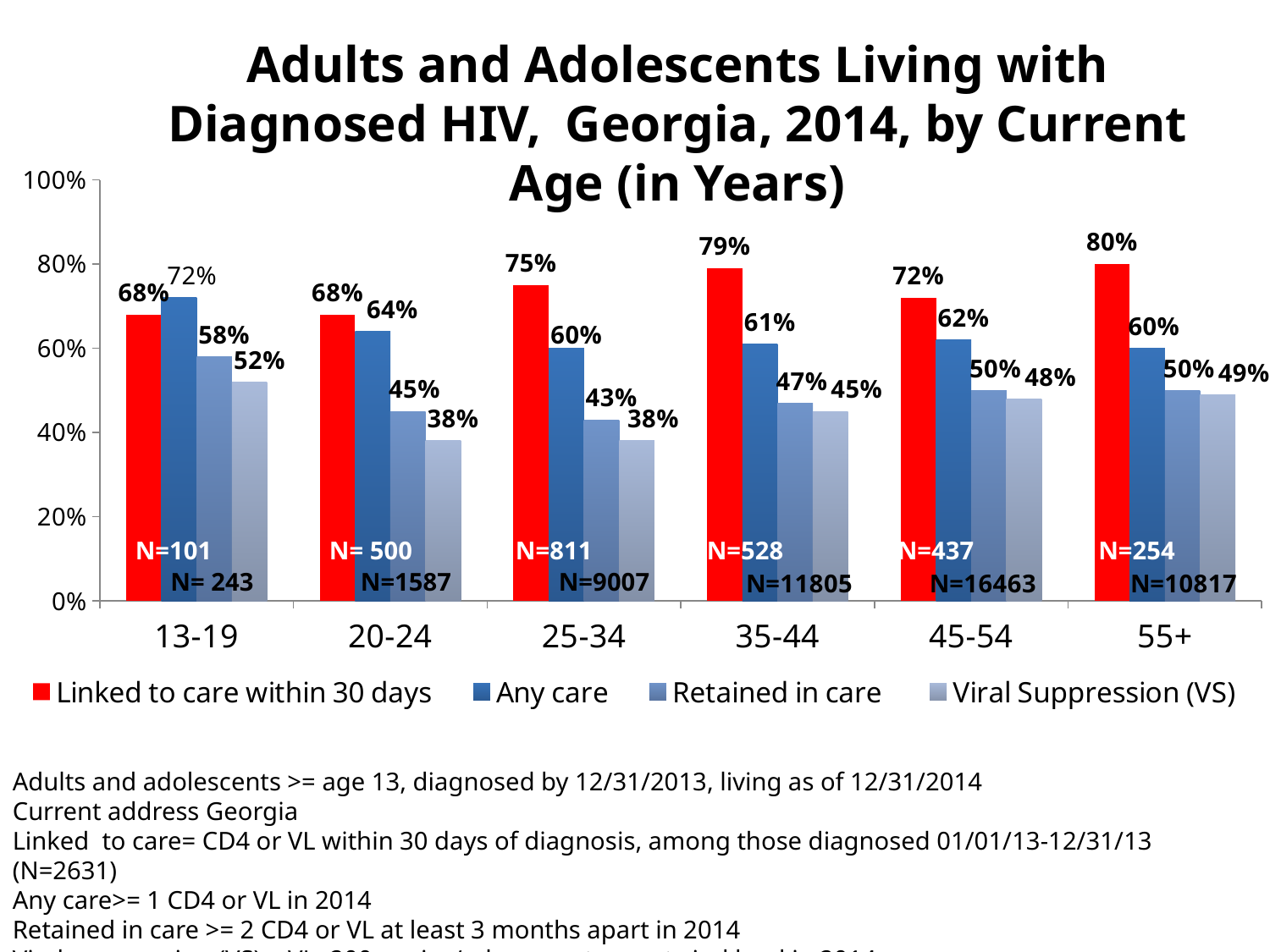
How many series does the legend list? 4 What is the Viral Suppression (VS) value for the 20-24 age group? 38% What kind of chart is shown on the slide? Bar chart Which age group has the highest value for Linked to care within 30 days? 55+ How many age groups are shown on the x axis? 6 What percentage of the 35-44 age group was linked to care within 30 days? 79% Which is larger for the 25-34 age group: Linked to care within 30 days or Any care? Linked to care within 30 days Which age group has the lowest Retained in care value? 25-34 Which colour represents Linked to care within 30 days in the legend? Red Is the Retained in care value for the 55+ age group greater or less than 40%? greater What is the Any care value for the 13-19 age group? 72% What is the difference between the Any care value and the Viral Suppression (VS) value for the 45-54 age group? 14%